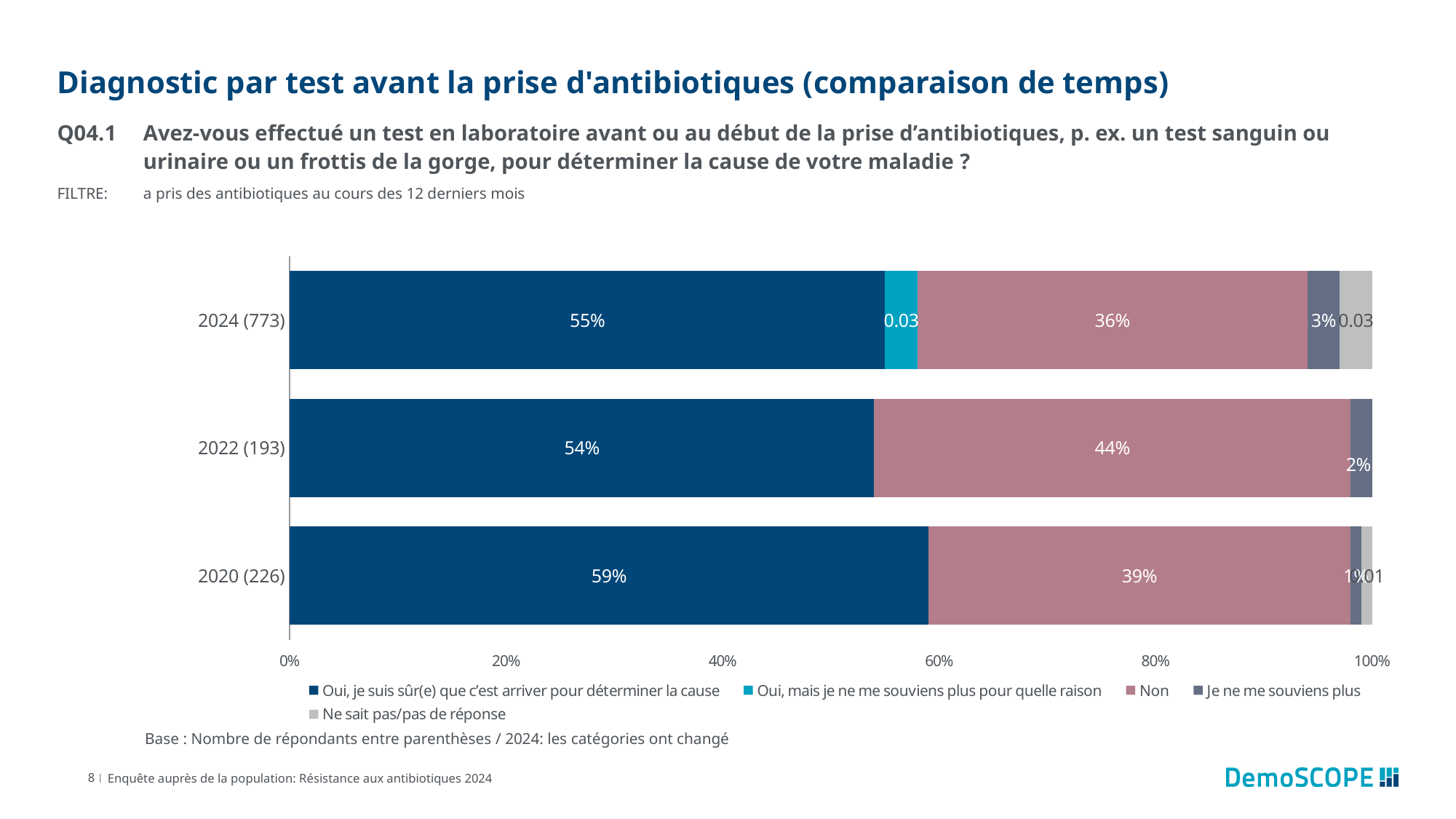
What is the difference between the "Non" share in 2022 (193) and in 2020 (226)? 5 percentage points What is the value for "Oui, mais je ne me souviens plus pour quelle raison" in 2024 (773)? 0.03 How many years (categories) are shown in the chart? 3 What is the value for "Je ne me souviens plus" in 2024 (773)? 3% Which year has the highest share of "Non"? 2022 (193) What is the value for "Oui, je suis sûr(e) que c'est arriver pour déterminer la cause" in 2024 (773)? 55% What is the value for "Non" in 2022 (193)? 44% What is the value for "Oui, je suis sûr(e) que c'est arriver pour déterminer la cause" in 2020 (226)? 59% What kind of chart is shown on the slide? Stacked bar chart Which year has the highest share of "Oui, je suis sûr(e) que c'est arriver pour déterminer la cause"? 2020 (226) Which is larger: the "Je ne me souviens plus" share in 2024 (773) or in 2022 (193)? 2024 (773) How many series does the legend list? 5